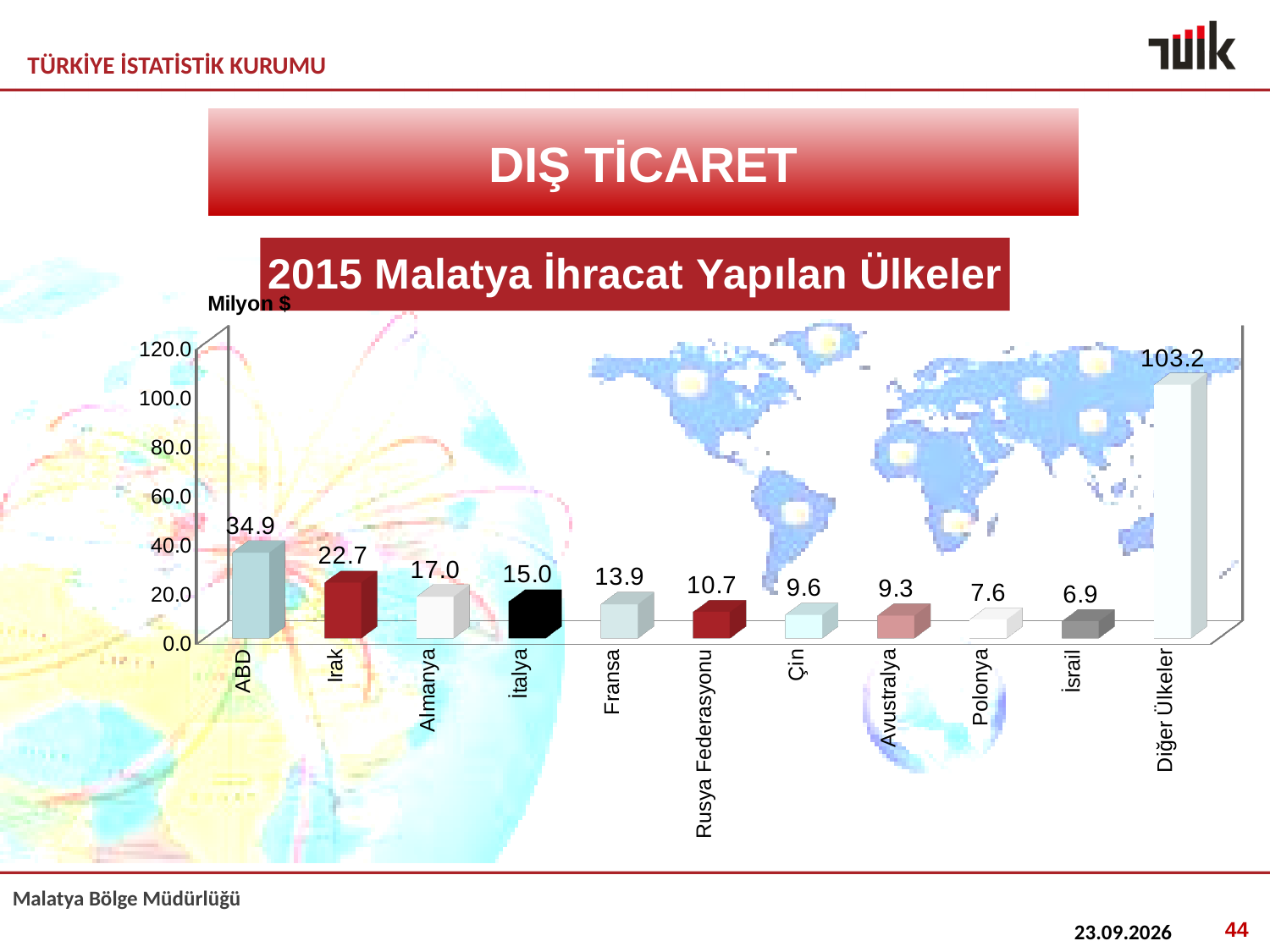
Which has a larger value, Almanya or Fransa? Almanya What is the value for ABD in the 2015 Malatya İhracat Yapılan Ülkeler chart? 34.9 What unit is shown above the y axis of the chart? Milyon $ What kind of chart is shown on the slide? bar chart Is the value for Diğer Ülkeler greater or less than 100.0? greater What is the title of the chart? 2015 Malatya İhracat Yapılan Ülkeler What is the value for Rusya Federasyonu? 10.7 Which country has the lowest value in the chart? İsrail Which category has the highest value in the chart? Diğer Ülkeler How many categories are shown on the x axis of the chart? 11 What is the value for Diğer Ülkeler? 103.2 What is the difference between the values for ABD and Irak? 12.2